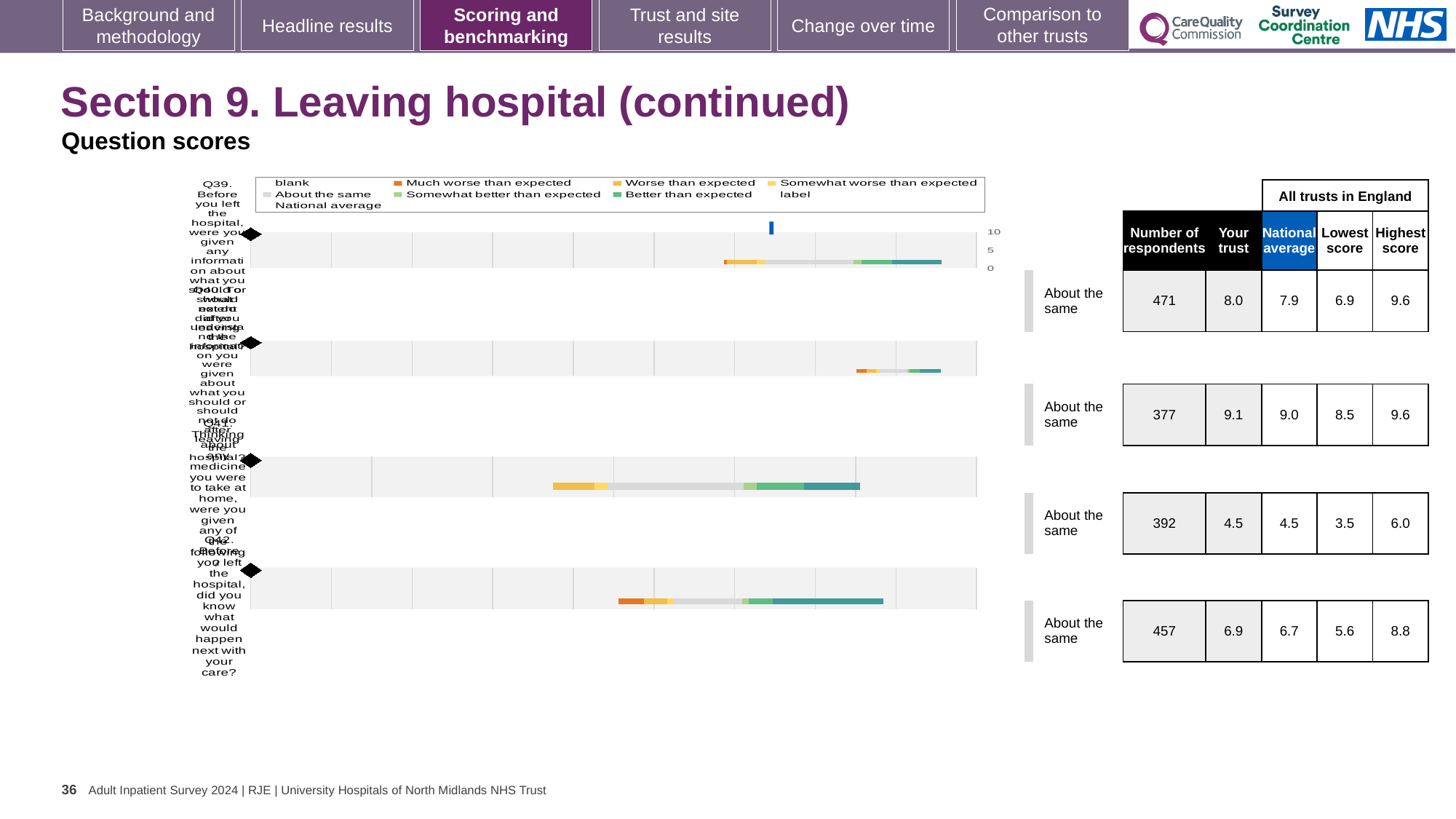
Which legend entry is shown in orange in the chart's legend? Much worse than expected How many question bars are plotted in the chart? 4 In the table beside the chart, what is the 'Your trust' score for the first row (Q39)? 8.0 In the table beside the chart, what is the difference between the 'Your trust' score and the national average for the last row (Q42)? 0.2 In the table beside the chart, is the number of respondents larger for the first row (Q39) or the second row? the first row (Q39) Which legend entry is shown in dark teal in the chart's legend? Better than expected In the table beside the chart, what is the number of respondents for the first row (Q39)? 471 What kind of chart is shown on the slide? bar chart In the table beside the chart, what is the highest score for the third row? 6.0 In the table beside the chart, which row has the highest 'Your trust' score? the second row (9.1) In the table beside the chart, which row has the lowest 'Your trust' score? the third row (4.5) In the table beside the chart, what is the national average for the last row (Q42)? 6.7